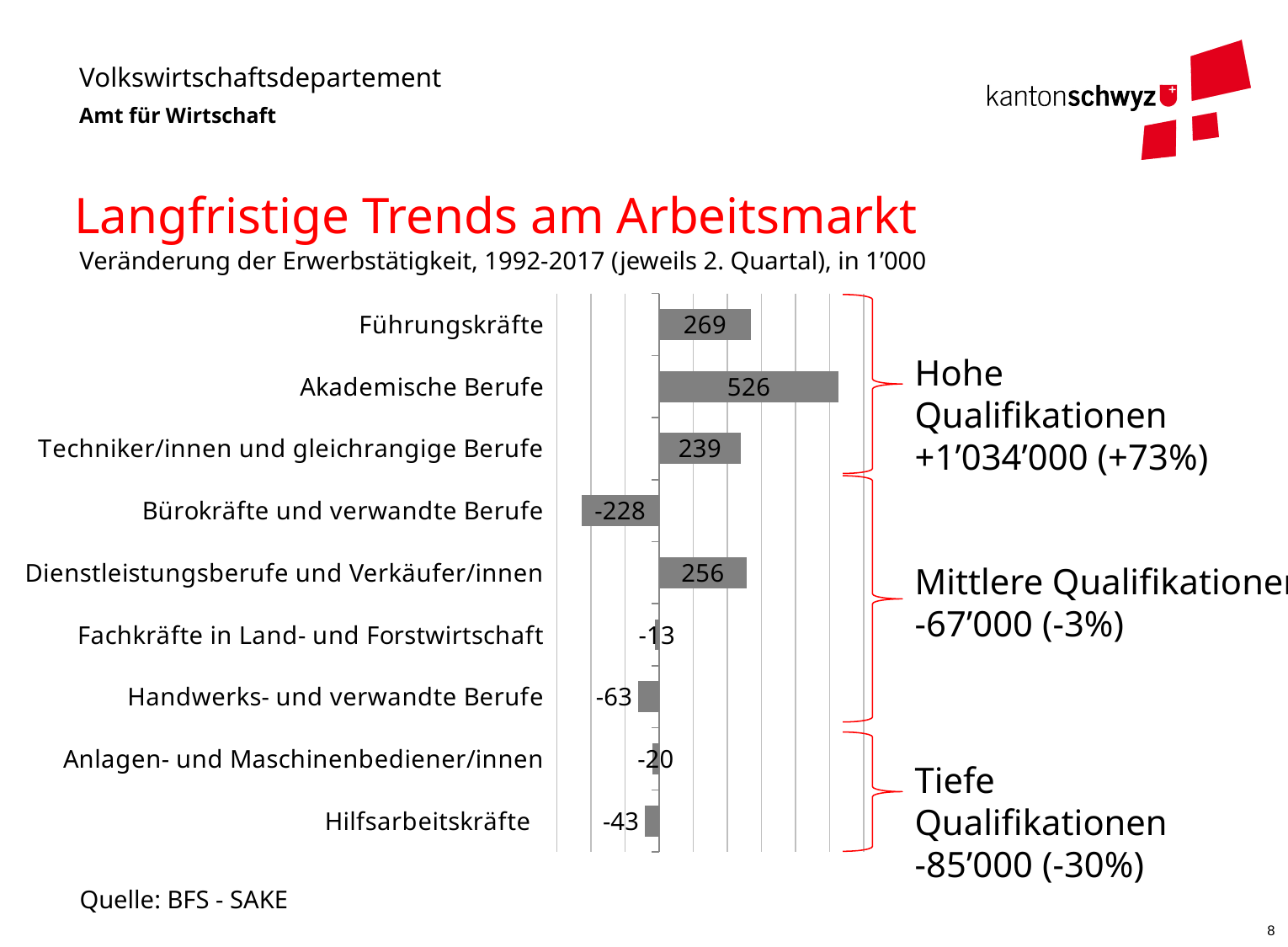
What is the difference between the values for Dienstleistungsberufe und Verkäufer/innen and Techniker/innen und gleichrangige Berufe? 17 What is the difference between the values for Akademische Berufe and Führungskräfte? 257 What is the value for Hilfsarbeitskräfte? -43 Which is larger, the value for Führungskräfte or the value for Techniker/innen und gleichrangige Berufe? Führungskräfte What is the value for Bürokräfte und verwandte Berufe? -228 What kind of chart is shown on the slide? Bar chart Which category has the highest value? Akademische Berufe Which category has the lowest value? Bürokräfte und verwandte Berufe What is the value for Handwerks- und verwandte Berufe? -63 How many categories are shown in the chart? 9 What is the subtitle describing the data shown in the chart? Veränderung der Erwerbstätigkeit, 1992-2017 (jeweils 2. Quartal), in 1'000 What is the value for Akademische Berufe? 526